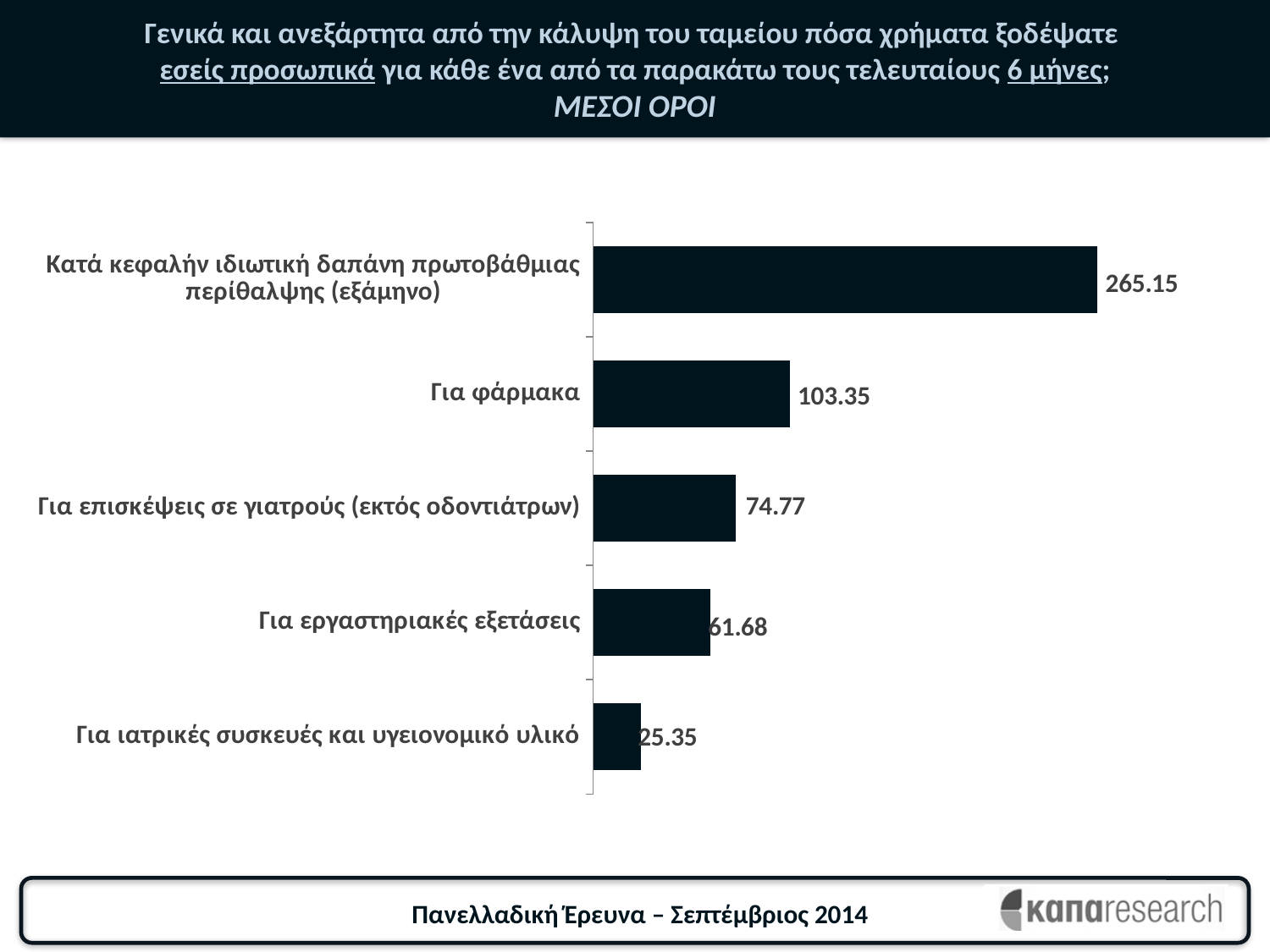
What is the value for "Για εργαστηριακές εξετάσεις"? 61.68 What is the difference between the values for "Για επισκέψεις σε γιατρούς (εκτός οδοντιάτρων)" and "Για εργαστηριακές εξετάσεις"? 13.09 How many categories are shown in the chart? 5 What is the value for "Για επισκέψεις σε γιατρούς (εκτός οδοντιάτρων)"? 74.77 Which is larger: the value for "Για εργαστηριακές εξετάσεις" or the value for "Για ιατρικές συσκευές και υγειονομικό υλικό"? Για εργαστηριακές εξετάσεις What is the value for "Κατά κεφαλήν ιδιωτική δαπάνη πρωτοβάθμιας περίθαλψης (εξάμηνο)"? 265.15 What is the value for "Για ιατρικές συσκευές και υγειονομικό υλικό"? 25.35 What kind of chart is shown on the slide? Bar chart Which category has the lowest value? Για ιατρικές συσκευές και υγειονομικό υλικό What is the value for "Για φάρμακα"? 103.35 Which category has the highest value? Κατά κεφαλήν ιδιωτική δαπάνη πρωτοβάθμιας περίθαλψης (εξάμηνο) What is the difference between the values for "Για φάρμακα" and "Για επισκέψεις σε γιατρούς (εκτός οδοντιάτρων)"? 28.58